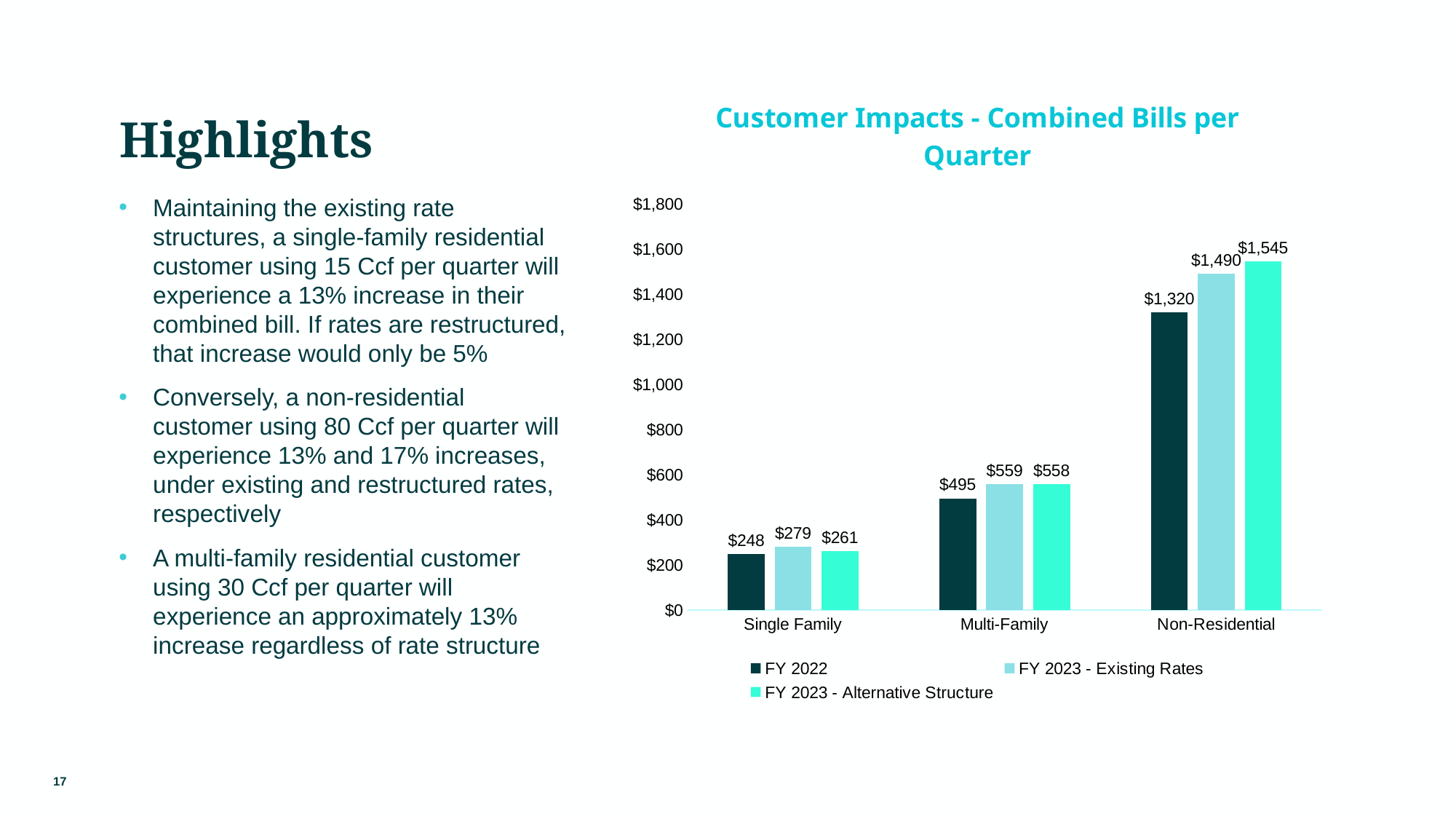
What is the title of the chart? Customer Impacts - Combined Bills per Quarter What kind of chart is shown on the slide? Bar chart Is the FY 2022 value for Multi-Family customers greater or less than $600? less Which customer category has the lowest FY 2023 - Alternative Structure bill? Single Family Which customer category has the highest FY 2022 combined bill? Non-Residential What is the FY 2023 - Alternative Structure value for Multi-Family customers? $558 What is the difference between the FY 2023 - Existing Rates and FY 2022 values for Non-Residential customers? $170 How many series does the legend list? 3 For Single Family customers, which is larger: the FY 2023 - Existing Rates value or the FY 2023 - Alternative Structure value? FY 2023 - Existing Rates How many customer categories are shown on the x axis? 3 What is the FY 2023 - Existing Rates value for Non-Residential customers? $1,490 What is the FY 2022 combined bill per quarter for Single Family customers? $248